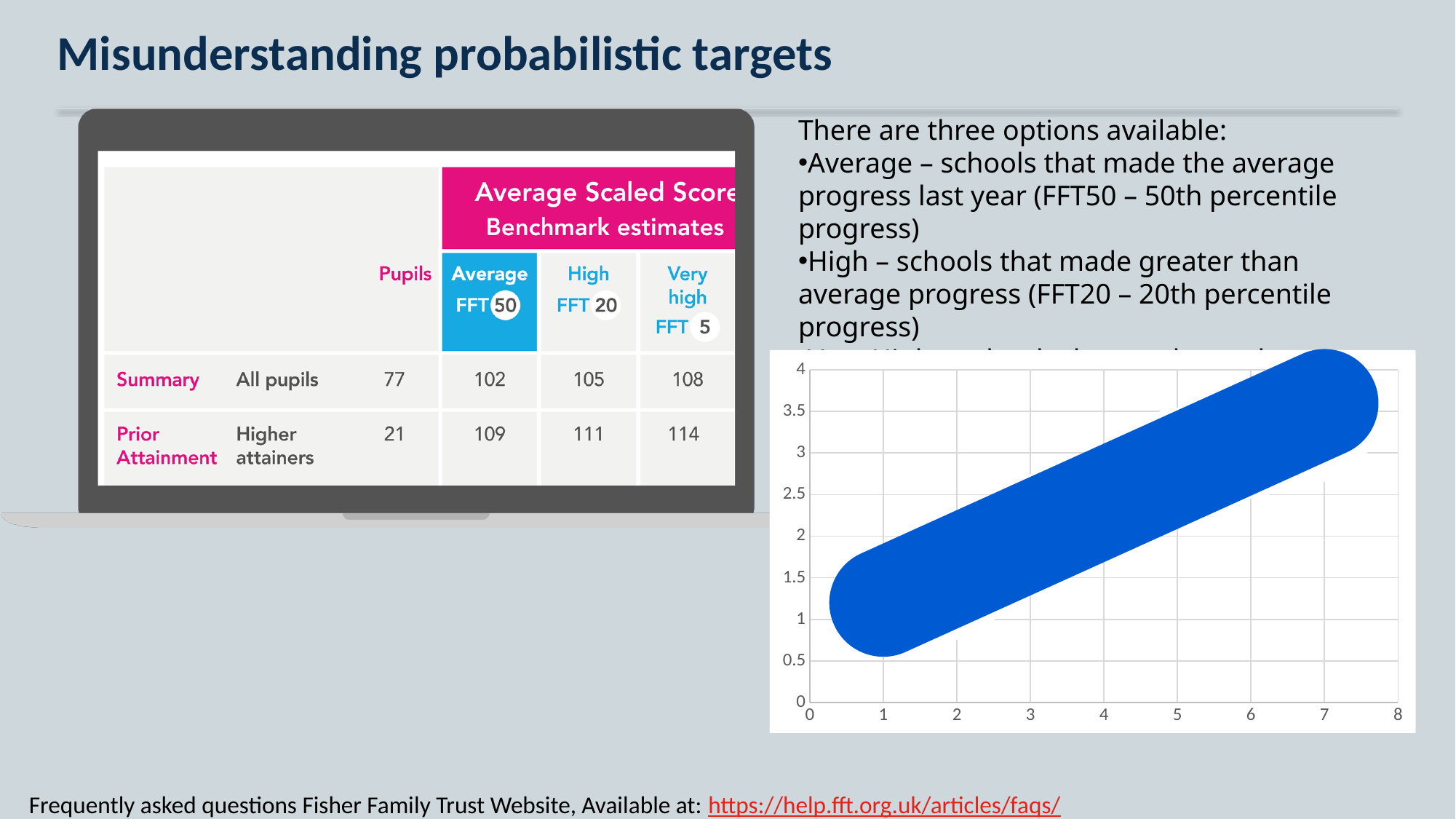
On the chart at the lower right, what is the highest value labelled on the horizontal axis? 8 On the chart at the lower right, how many series does the legend list? No legend is shown On the chart at the lower right, does the blue band rise or fall as you move from left to right along the x axis? rise On the chart at the lower right, what is the highest value labelled on the vertical axis? 4